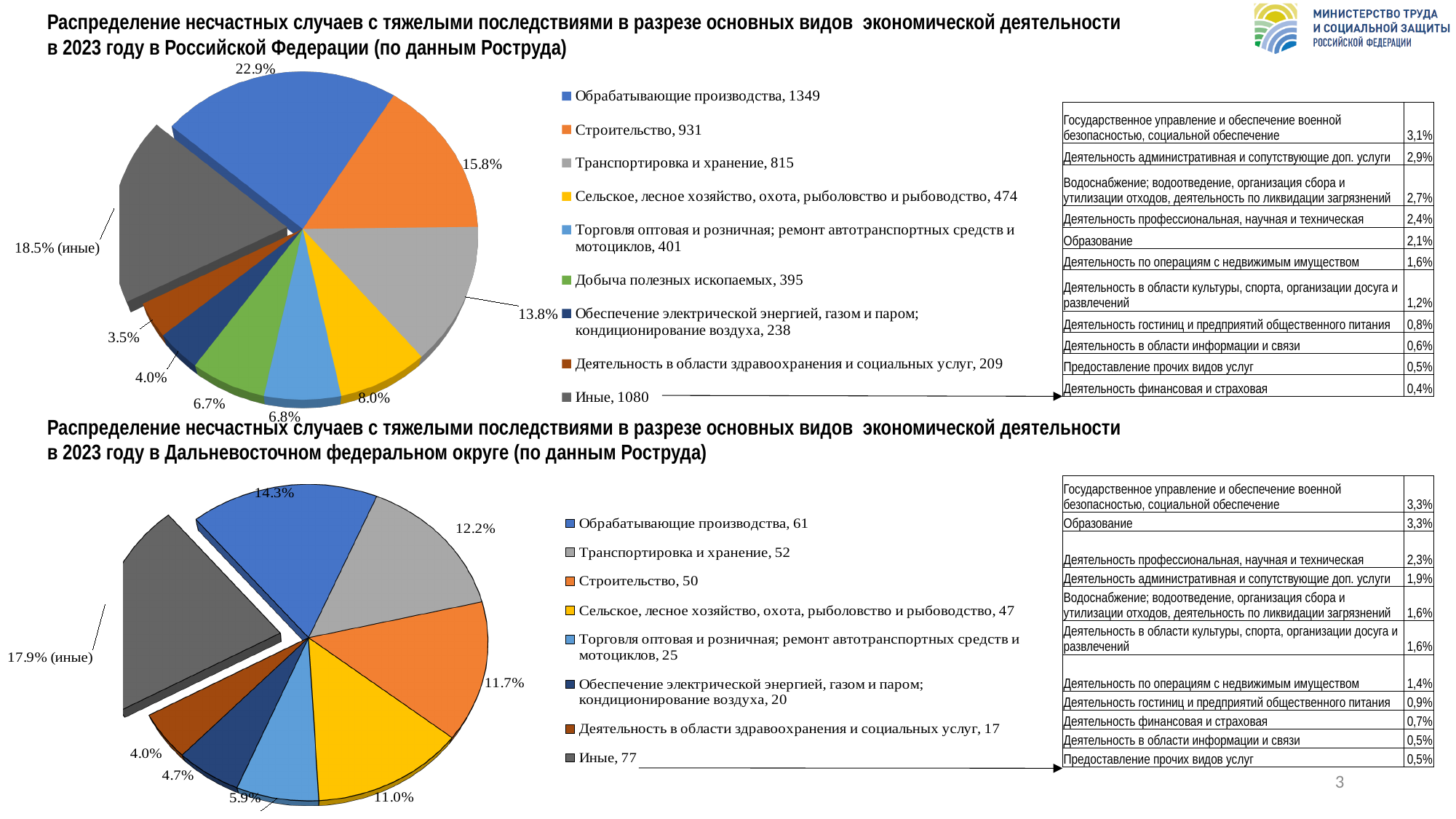
What type of chart is used for both charts on the slide? Pie chart In the top pie chart (Russian Federation), what is the difference between the accident counts for Строительство and Транспортировка и хранение? 116 In the top pie chart (Russian Federation), how many severe accidents are listed for Обрабатывающие производства? 1349 In the bottom pie chart (Far Eastern Federal District), what is the difference between the accident counts for Обрабатывающие производства and Сельское, лесное хозяйство, охота, рыболовство и рыбоводство? 14 In the bottom pie chart (Far Eastern Federal District), which is larger: Транспортировка и хранение or Строительство? Транспортировка и хранение In the top pie chart (Russian Federation), what percentage share is labelled for Строительство? 15.8% In the top pie chart (Russian Federation), which category has the smallest number of accidents? Деятельность в области здравоохранения и социальных услуг In the top pie chart (Russian Federation), which named category (excluding Иные) has the largest number of accidents? Обрабатывающие производства In the bottom pie chart (Far Eastern Federal District), what percentage share is labelled for Обрабатывающие производства? 14.3% In the bottom pie chart (Far Eastern Federal District), how many accidents are listed for Иные? 77 In the top pie chart (Russian Federation), how many categories does the legend list? 9 In the bottom pie chart (Far Eastern Federal District), how many categories does the legend list? 8